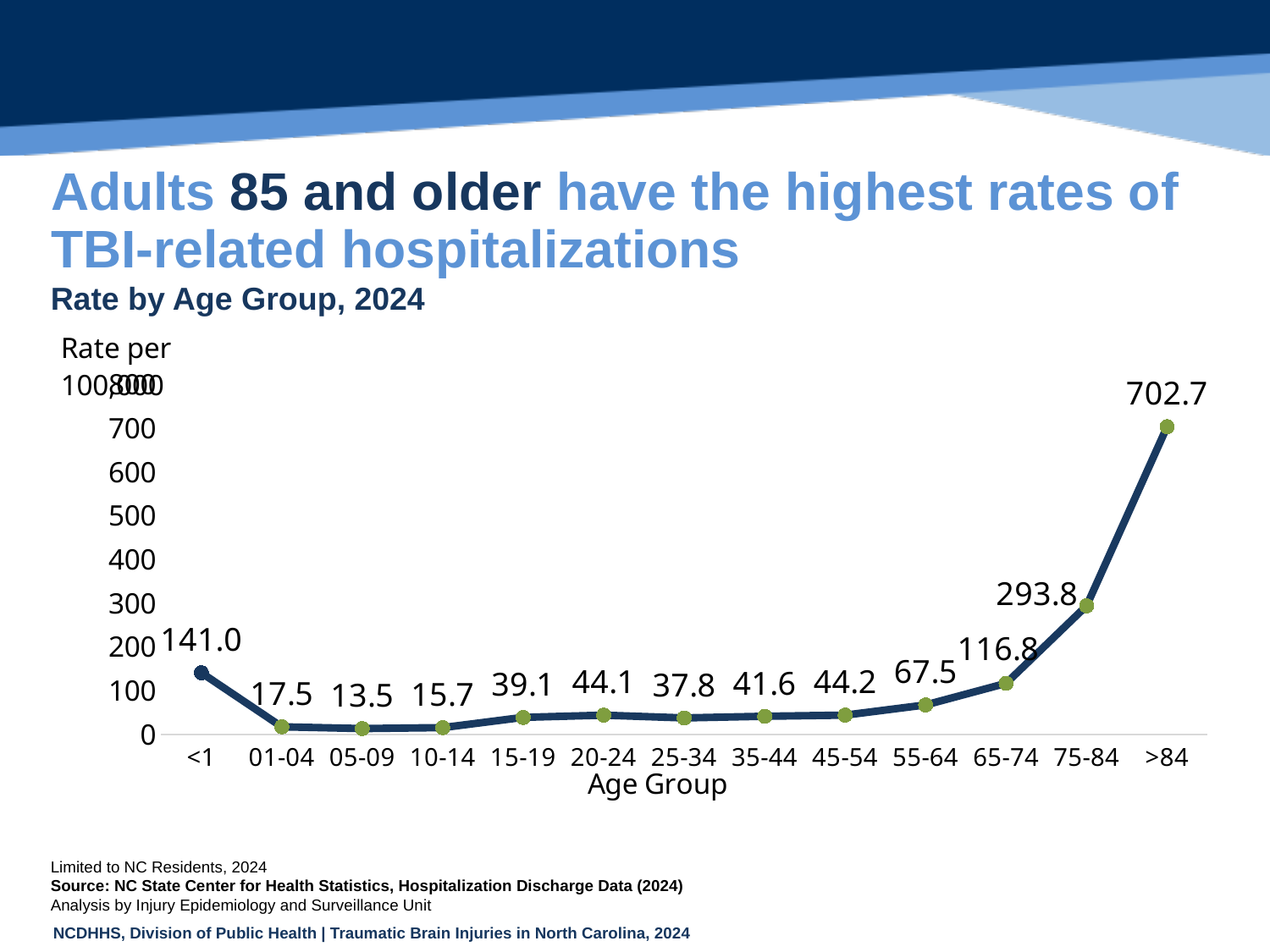
Is the rate for the 75-84 age group greater or less than 200? greater How many age groups are plotted on the chart? 13 What is the difference between the rates for the <1 and 01-04 age groups? 123.5 What is the rate for the 65-74 age group? 116.8 What is the difference between the rates for the >84 and 75-84 age groups? 408.9 What type of chart is shown on the slide? Line chart What is the TBI-related hospitalization rate for the >84 age group? 702.7 Which age group has the lowest rate? 05-09 Which has a higher rate, the 55-64 age group or the 45-54 age group? 55-64 What is the label of the x axis? Age Group What is the rate for the <1 age group? 141.0 Which age group has the highest rate? >84